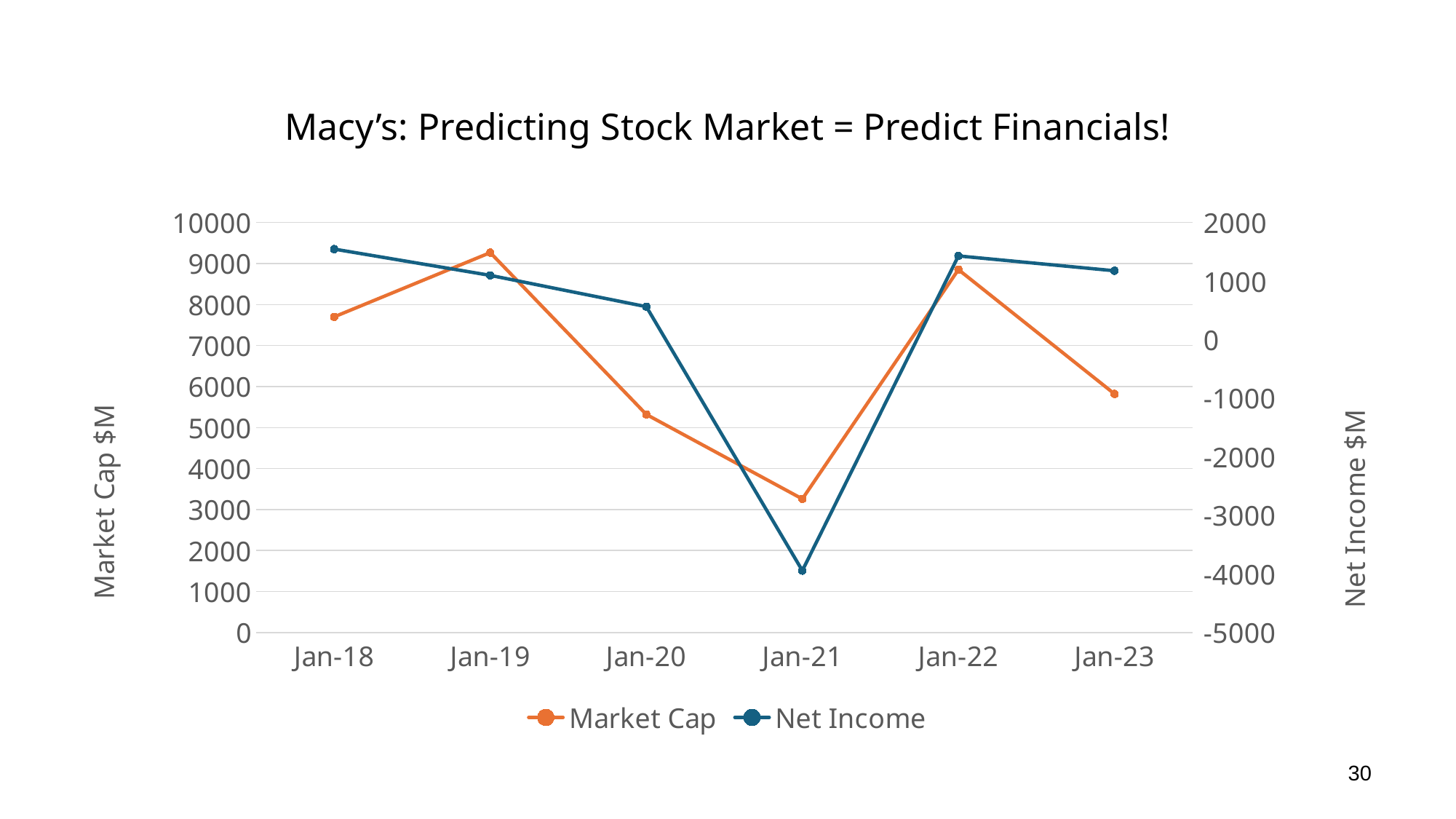
What kind of chart is shown on the slide? line chart At which date is Market Cap lowest? Jan-21 Which is larger, the Market Cap for Jan-18 or for Jan-23? Jan-18 Is the Net Income value for Jan-21 greater or less than -3000? less At which date is Market Cap highest? Jan-19 Is the Market Cap value for Jan-21 greater or less than 4000? less At which date is Net Income lowest? Jan-21 What is the title of the right-hand vertical axis? Net Income $M How many series does the legend list? 2 How many dates are plotted along the x axis? 6 Does Market Cap rise or fall from Jan-19 to Jan-21? fall Is the Market Cap value for Jan-19 greater or less than 9000? greater